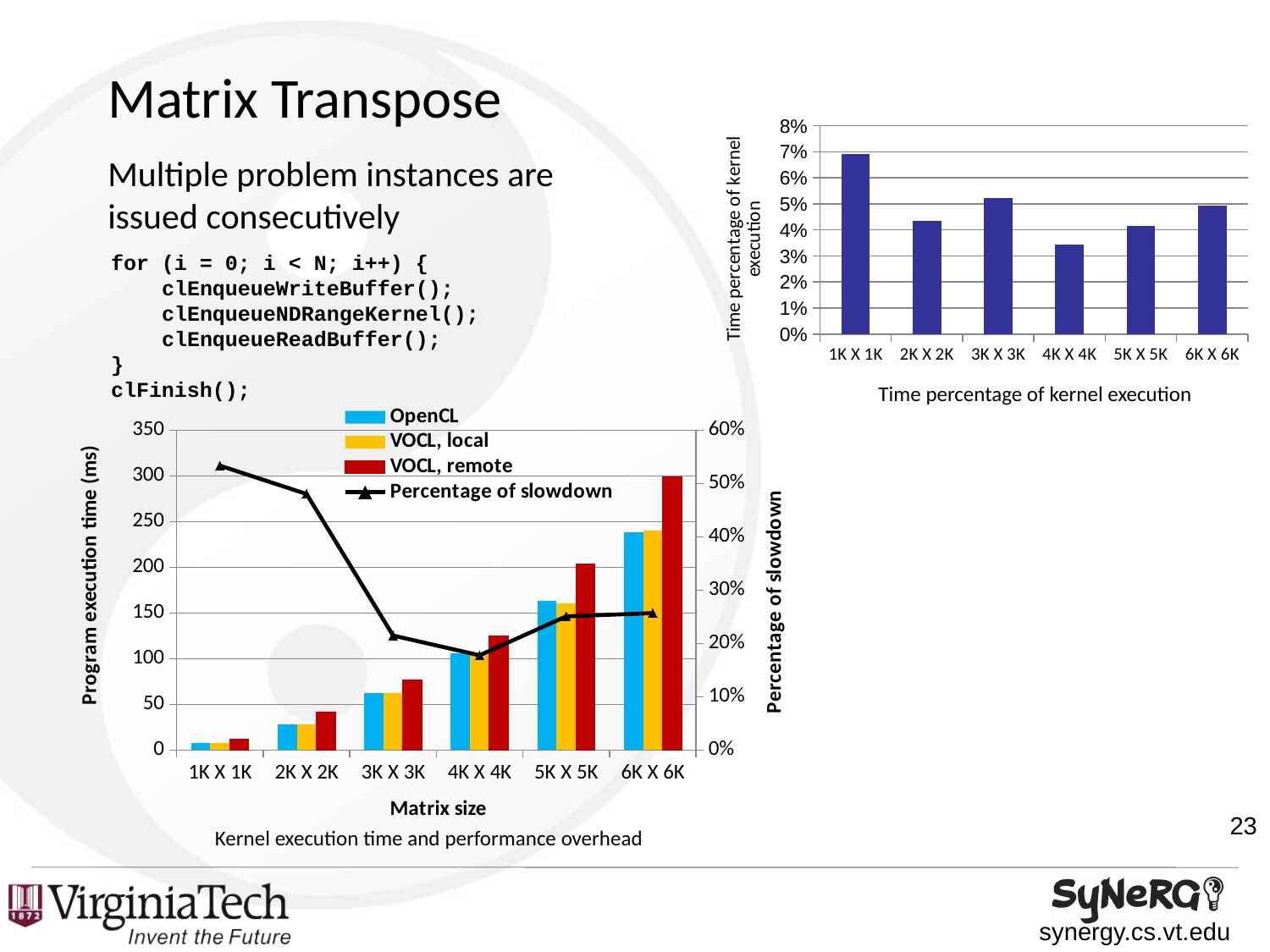
In the 'Time percentage of kernel execution' chart, is the value for 4K X 4K greater or less than 4%? less In the 'Time percentage of kernel execution' chart, how many matrix sizes are shown on the x axis? 6 In the 'Kernel execution time and performance overhead' chart, how many series does the legend list? 4 In the 'Kernel execution time and performance overhead' chart, which matrix size has the lowest percentage of slowdown? 4K X 4K In the 'Kernel execution time and performance overhead' chart, what is the label of the left y axis? Program execution time (ms) In the 'Time percentage of kernel execution' chart, which matrix size has the lowest time percentage? 4K X 4K In the 'Kernel execution time and performance overhead' chart, which matrix size has the highest percentage of slowdown? 1K X 1K In the 'Kernel execution time and performance overhead' chart, for 6K X 6K, which is larger: the OpenCL execution time or the VOCL, remote execution time? VOCL, remote In the 'Kernel execution time and performance overhead' chart, is the VOCL, remote execution time for 6K X 6K greater or less than 250 ms? greater In the 'Kernel execution time and performance overhead' chart, do the OpenCL execution times rise or fall as the matrix size increases? rise In the 'Time percentage of kernel execution' chart, which matrix size has the highest time percentage? 1K X 1K In the 'Time percentage of kernel execution' chart, is the value for 1K X 1K greater or less than 6%? greater